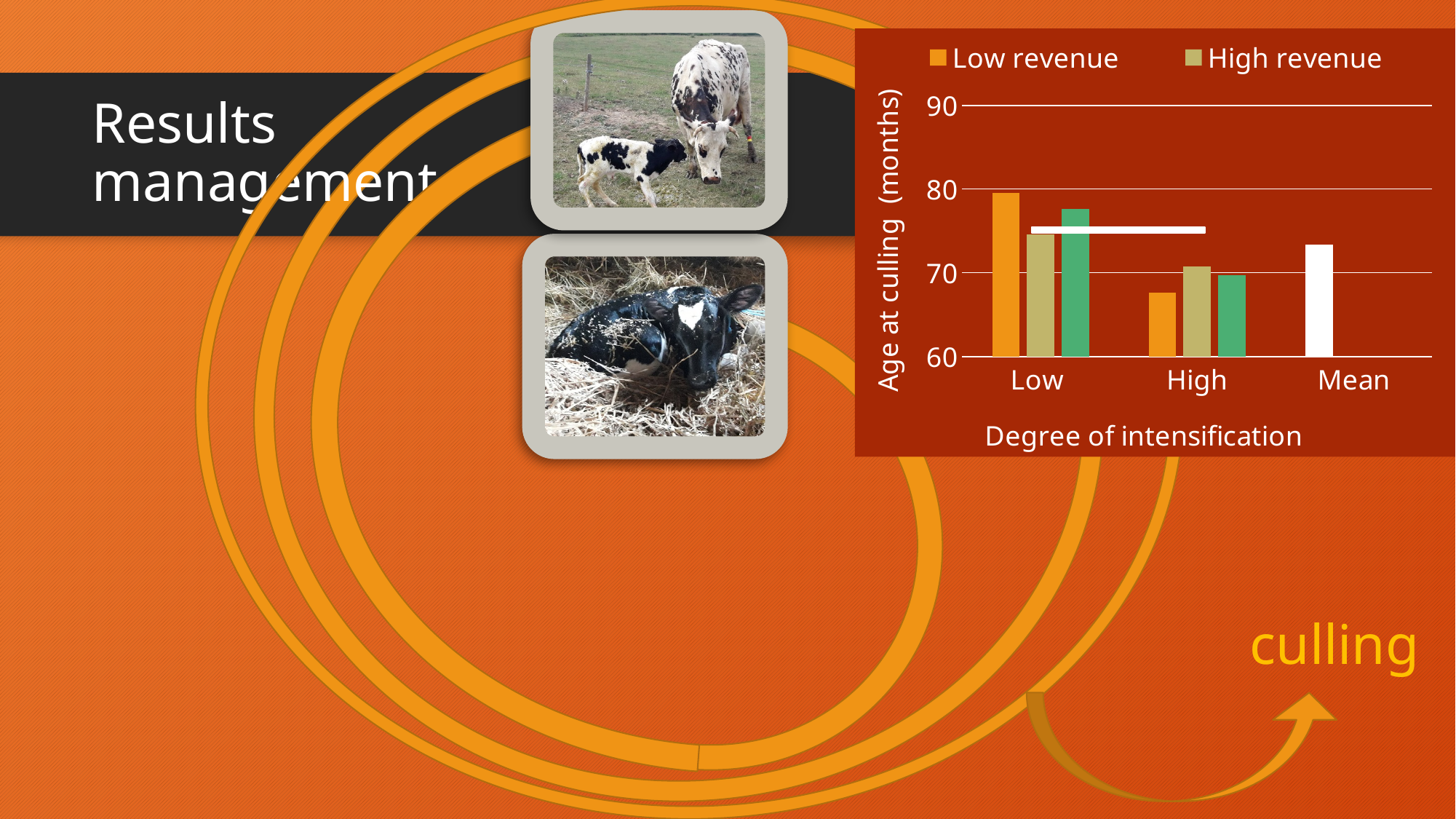
What kind of chart is shown on the slide? bar chart What is the title of the x axis of the chart? Degree of intensification How many categories are shown on the x axis of the chart? 3 Is the Low revenue value for the Low category greater or less than 70? greater What is the title of the y axis of the chart? Age at culling (months) In the Low category, which series has the larger value, Low revenue or High revenue? Low revenue Which is larger, the Low revenue value for Low or the Low revenue value for High? Low How many series does the chart legend list? 2 Does the Low revenue series rise or fall from the Low category to the High category? fall Is the value for the Mean category greater or less than 70? greater Is the Low revenue value for the High category greater or less than 70? less In the High category, which series has the larger value, Low revenue or High revenue? High revenue